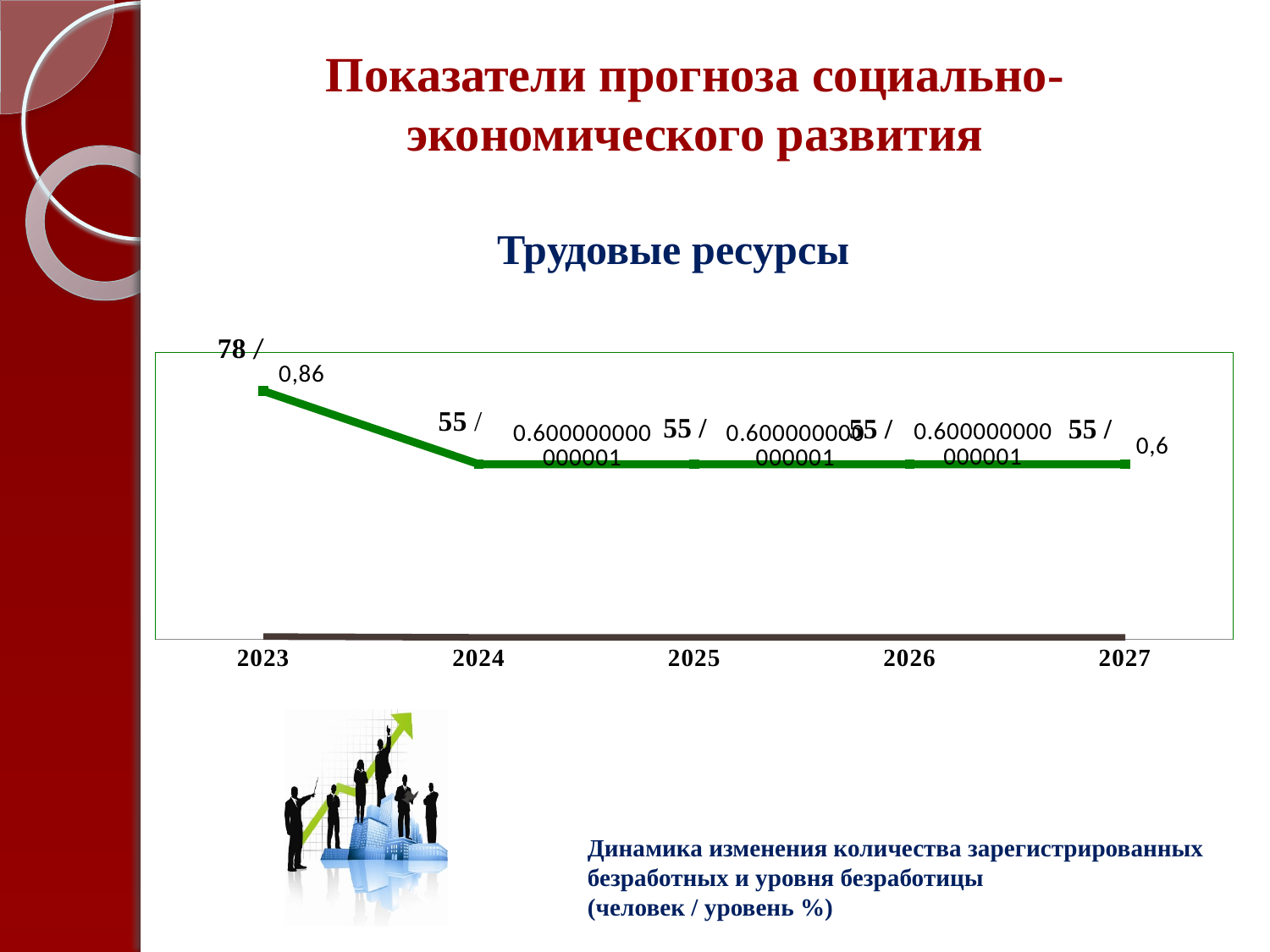
What is the number of registered unemployed shown for 2025? 55 What is the number of registered unemployed shown for 2027? 55 What kind of chart is shown on the slide? line chart How many years are plotted along the x axis of the chart? 5 How does the line change from 2023 to 2027? It falls from 2023 to 2024, then stays flat What is the title shown above the chart? Трудовые ресурсы By how much does the number of registered unemployed fall from 2023 to 2024? 23 What unemployment level (%) is shown for 2027? 0,6 Which year has the larger number of registered unemployed, 2023 or 2026? 2023 What is the number of registered unemployed shown for 2023? 78 Which year has the highest number of registered unemployed? 2023 What unemployment level (%) is shown for 2023? 0,86